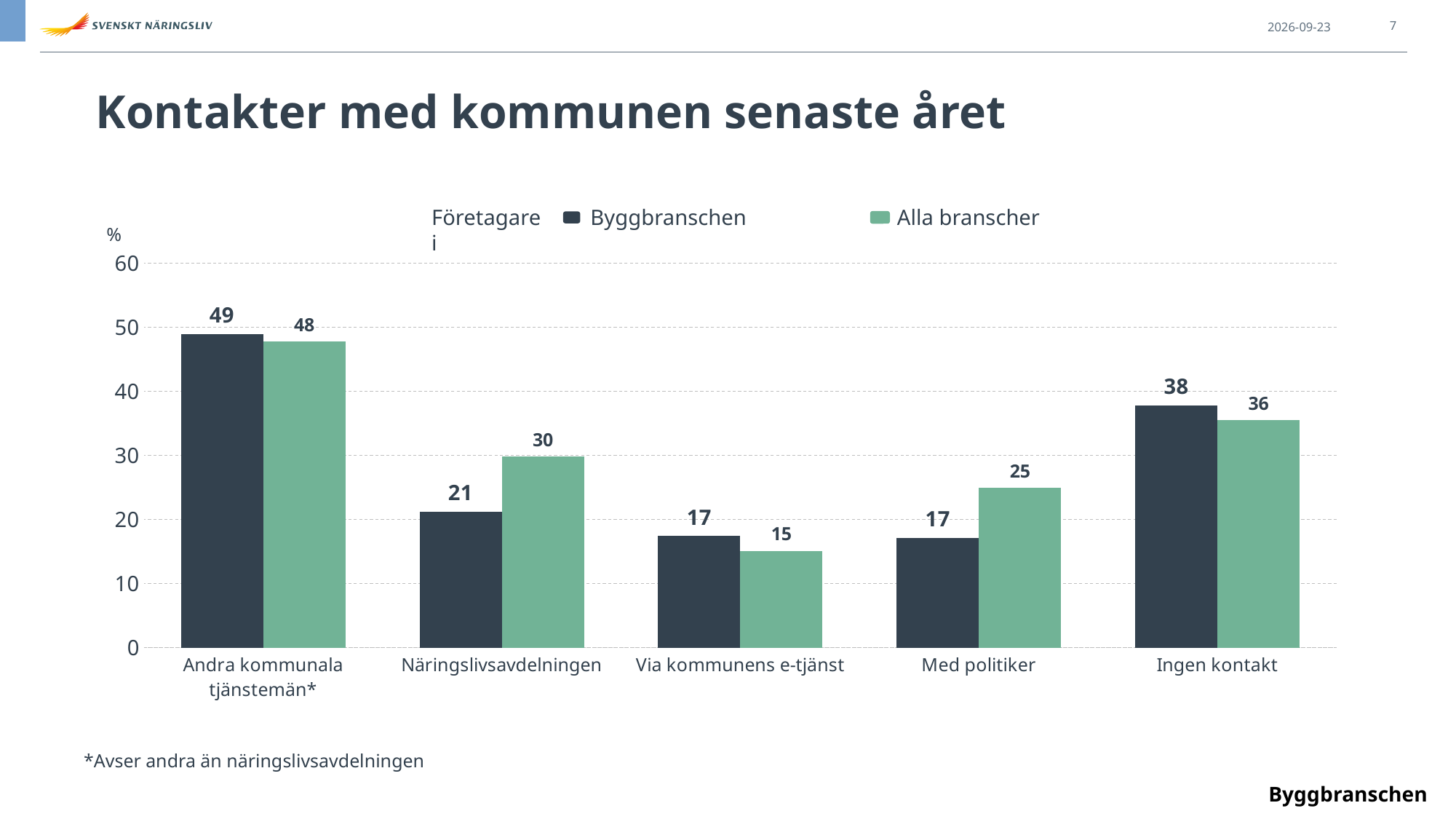
How many categories are shown on the x axis? 5 Which category has the highest value for Byggbranschen? Andra kommunala tjänstemän* Which is larger in the Via kommunens e-tjänst category: Byggbranschen or Alla branscher? Byggbranschen How many series does the legend list? 2 What is the value for Alla branscher in the Med politiker category? 25 Which category has the lowest value for Alla branscher? Via kommunens e-tjänst What kind of chart is shown on the slide? Bar chart What is the value for Alla branscher in the Näringslivsavdelningen category? 30 What is the value for Byggbranschen in the Ingen kontakt category? 38 What is the difference between Alla branscher and Byggbranschen in the Näringslivsavdelningen category? 9 What is the title of the chart on the slide? Kontakter med kommunen senaste året What is the value for Byggbranschen in the Andra kommunala tjänstemän* category? 49